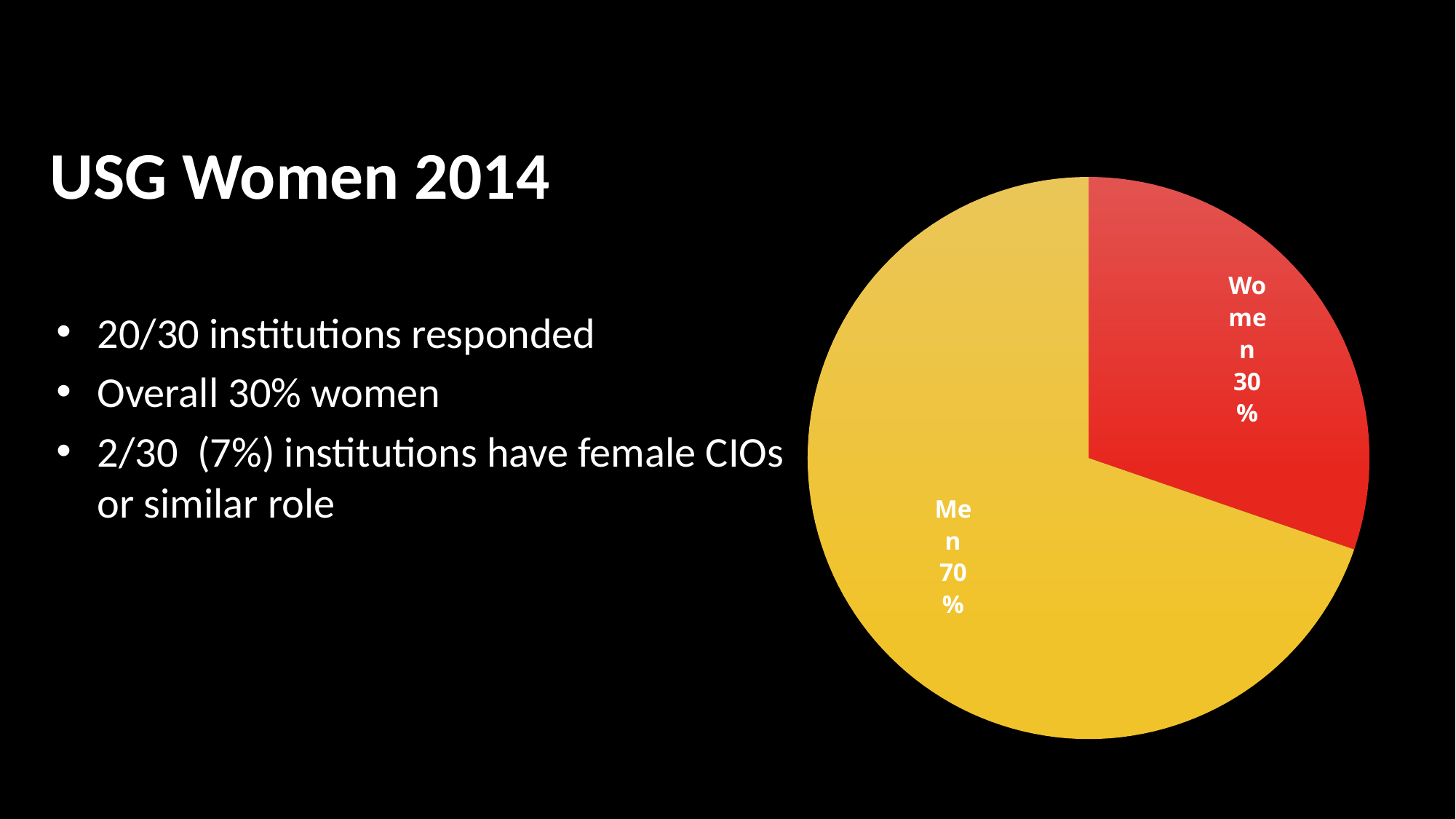
What kind of chart is shown on the slide? pie chart What share of the pie does the Men slice represent? 70% Which slice of the pie is the largest? Men Which slice of the pie is the smallest? Women What colour is the Men slice of the pie? yellow What colour is the Women slice of the pie? red Which slice is larger, Men or Women? Men How many slices does the pie chart have? 2 What share of the pie does the Women slice represent? 30% What is the difference in percentage points between the Men slice and the Women slice? 40 percentage points